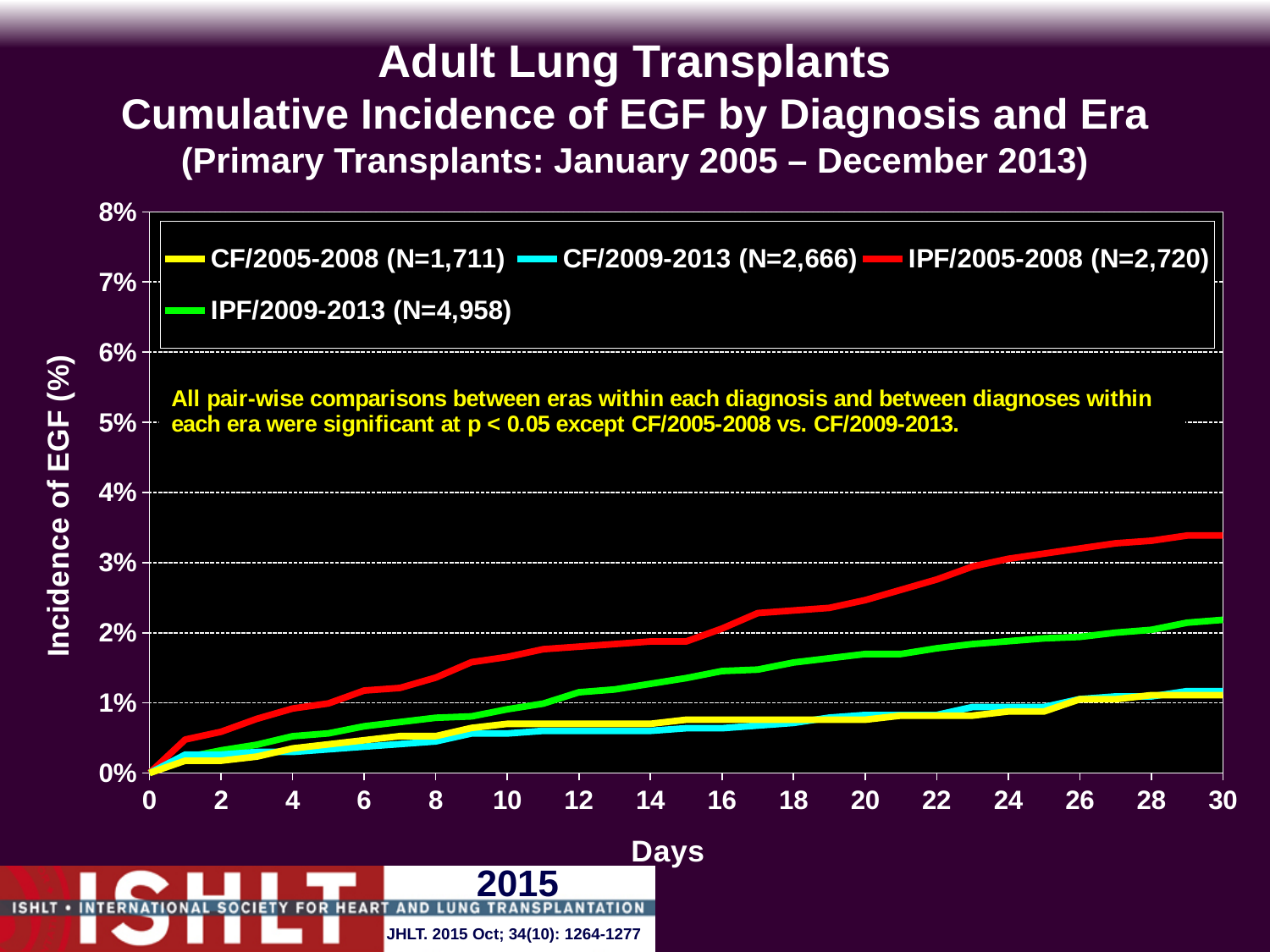
At day 30, which is larger: the value for IPF/2009-2013 or the value for CF/2009-2013? IPF/2009-2013 Which series has the highest cumulative incidence of EGF at day 30? IPF/2005-2008 (N=2,720) Is the value for IPF/2005-2008 at day 30 greater or less than 3%? greater Do the values for IPF/2005-2008 rise or fall as the number of days increases? Rise Is the value for CF/2005-2008 at day 20 greater or less than 1%? less At day 30, which is larger: the value for IPF/2005-2008 or the value for IPF/2009-2013? IPF/2005-2008 How many series does the legend list? 4 What is the N shown in the legend for the IPF/2009-2013 series? N=4,958 Is the value for IPF/2009-2013 at day 30 greater or less than 2%? greater What kind of chart is shown on the slide? Line chart What is the label of the y axis? Incidence of EGF (%)